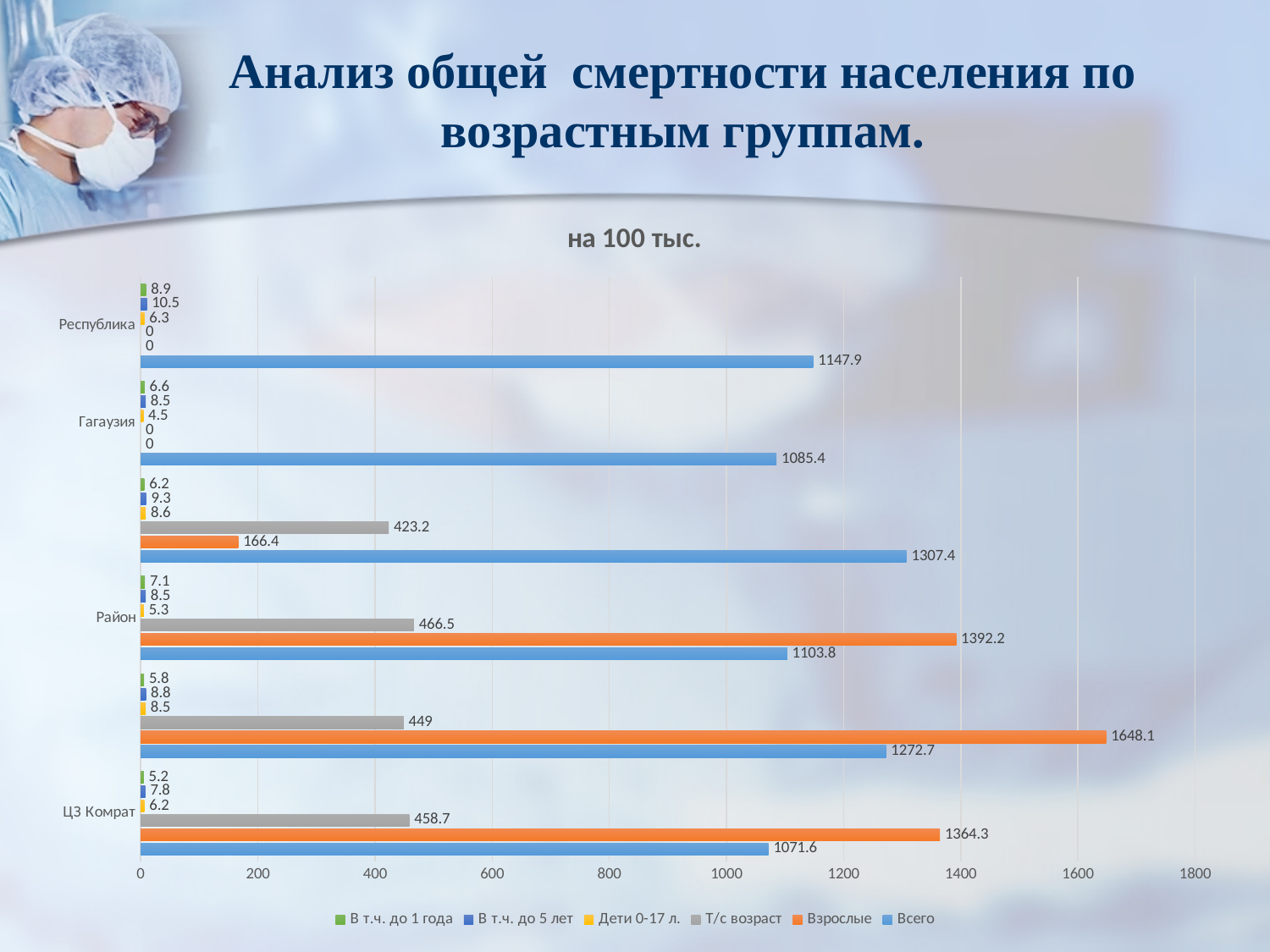
What is the value of Всего for Республика? 1147.9 What is the difference between Взрослые for Район and Взрослые for ЦЗ Комрат? 27.9 What kind of chart is shown on the slide? bar chart What is the title of the chart? на 100 тыс. What is the value of Т/с возраст for ЦЗ Комрат? 458.7 What is the value of Взрослые for Район? 1392.2 What is the value of В т.ч. до 1 года for ЦЗ Комрат? 5.2 What is the value of Дети 0-17 л. for Республика? 6.3 What is the value of В т.ч. до 5 лет for Гагаузия? 8.5 How many series does the legend list? 6 Is the value of Всего for ЦЗ Комрат greater or less than 1000? greater Which is larger: Всего for Республика or Всего for Гагаузия? Республика